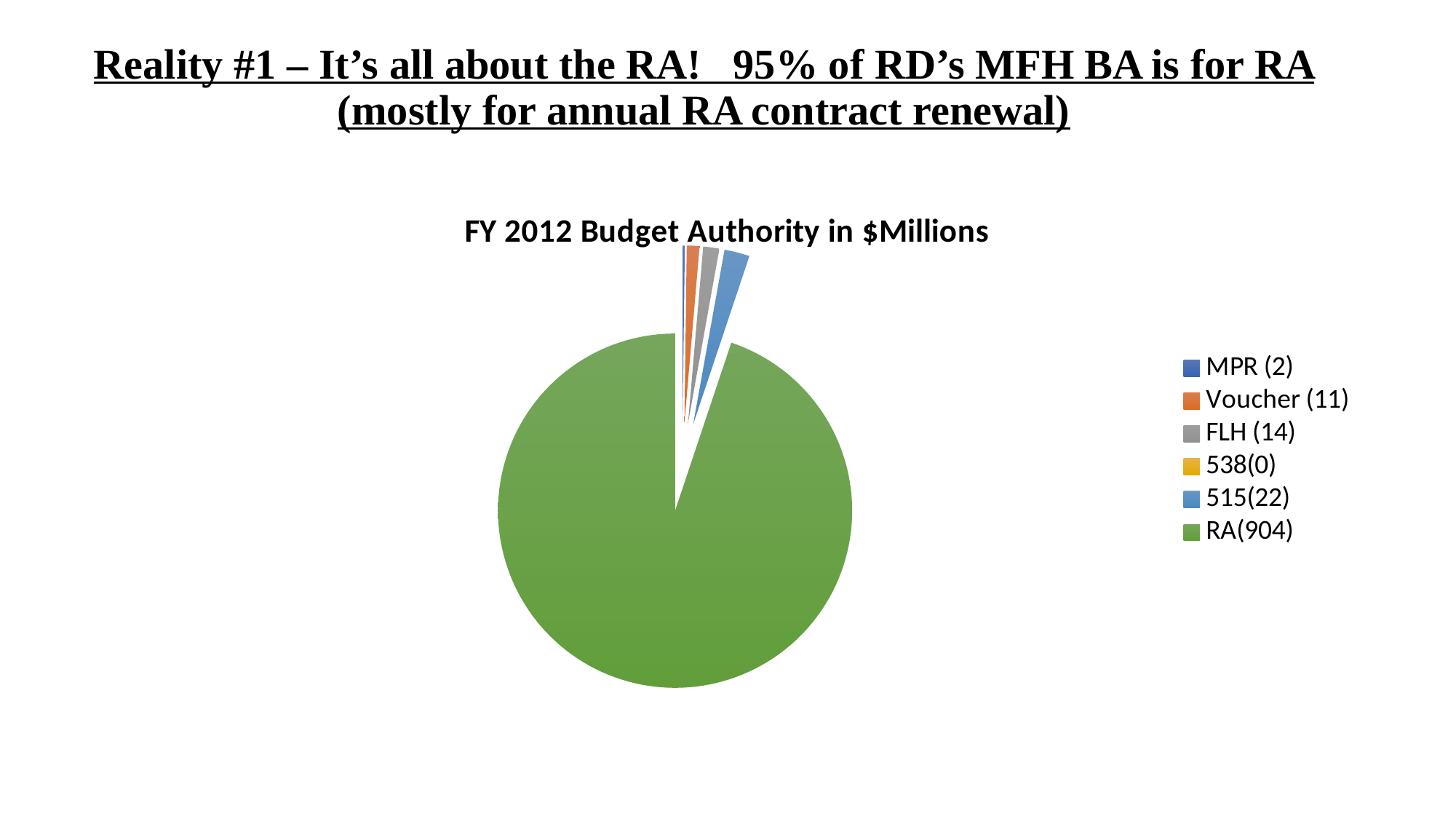
What is the value for 515 in the pie chart? 22 Which category has the largest slice of the pie? RA How many categories does the legend list? 6 What is the difference between the values for 515 and FLH? 8 What is the value for MPR in the pie chart? 2 What is the value for FLH in the pie chart? 14 Which category has the smallest value in the pie chart? 538 What is the chart's title? FY 2012 Budget Authority in $Millions What kind of chart is shown on the slide? pie chart Which is larger, the value for Voucher or the value for FLH? FLH What is the value for Voucher in the pie chart? 11 What is the value for RA in the pie chart? 904